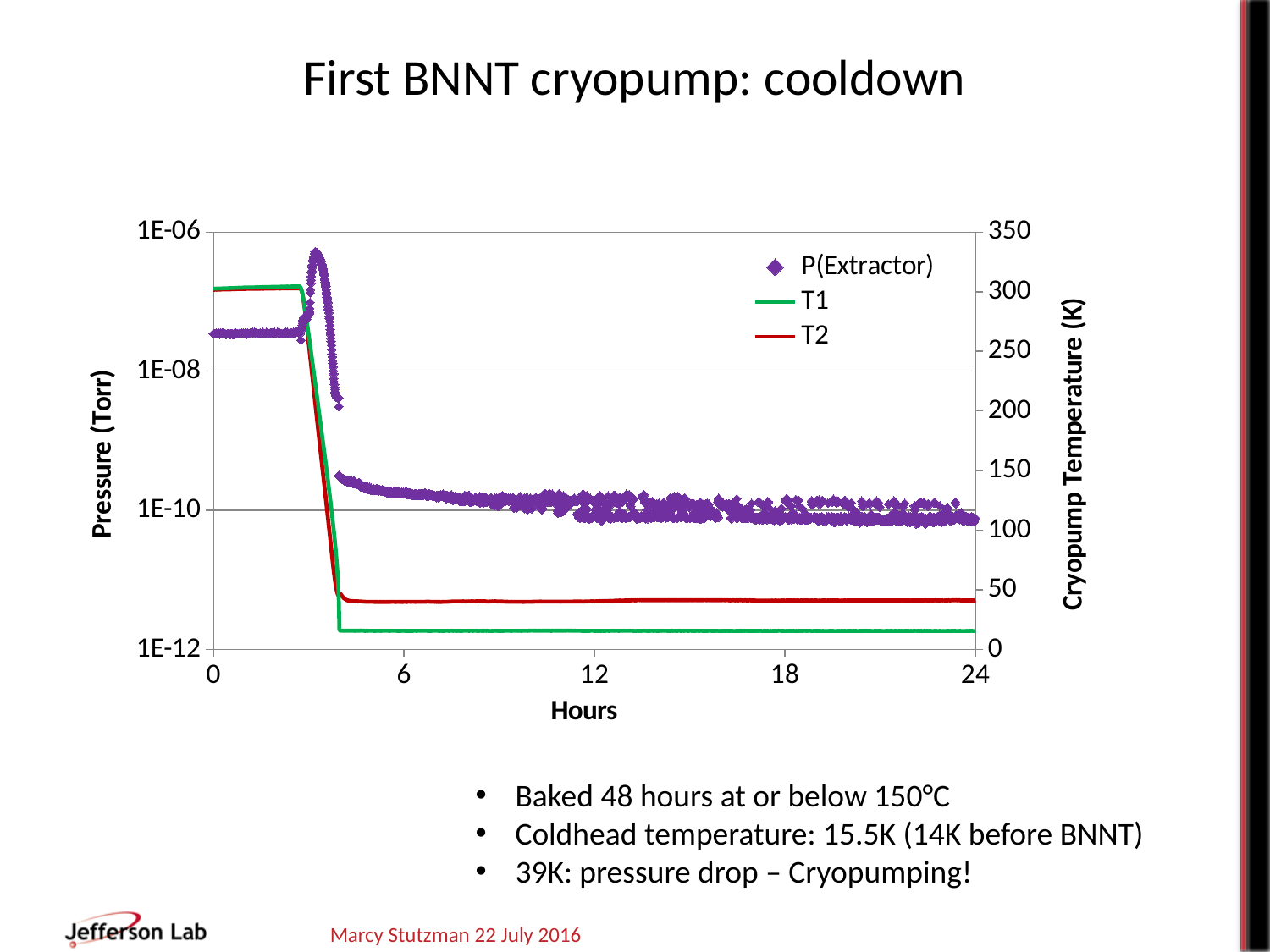
What kind of chart is shown on the slide? line chart Is the value of T2 at 12 hours greater or less than 100? less Which series is plotted with purple diamond markers? P(Extractor) At 12 hours, which is larger, T1 or T2? T2 Is the value of P(Extractor) at 0 hours greater or less than 1E-10? greater Is the value of P(Extractor) at 12 hours greater or less than 1E-08? less Does the T1 series rise or fall overall from 0 to 24 hours? fall What is the label of the x axis of the chart? Hours What is the label of the right-hand y axis of the chart? Cryopump Temperature (K) How many series does the chart legend list? 3